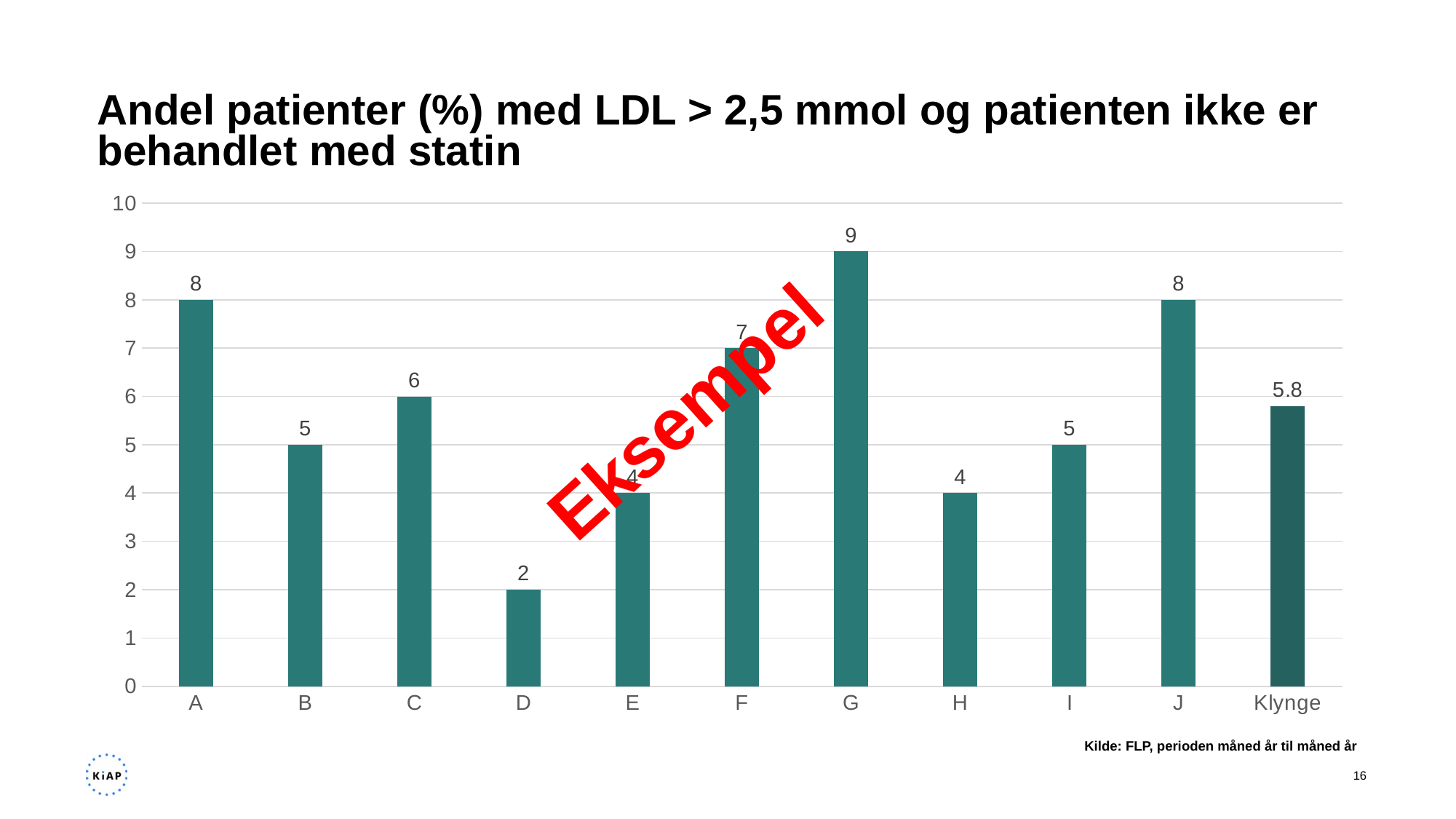
What is the value for category D? 2 What is the difference between the values for G and D? 7 How many categories are shown on the x axis? 11 Which is larger, the value for C or the value for H? C What is the difference between the values for J and Klynge? 2.2 What is the value for Klynge? 5.8 Which category has the highest value? G What is the source noted below the chart? Kilde: FLP, perioden måned år til måned år What is the title of the chart? Andel patienter (%) med LDL > 2,5 mmol og patienten ikke er behandlet med statin Which category has the lowest value? D What kind of chart is shown on the slide? Bar chart What is the value for category G? 9